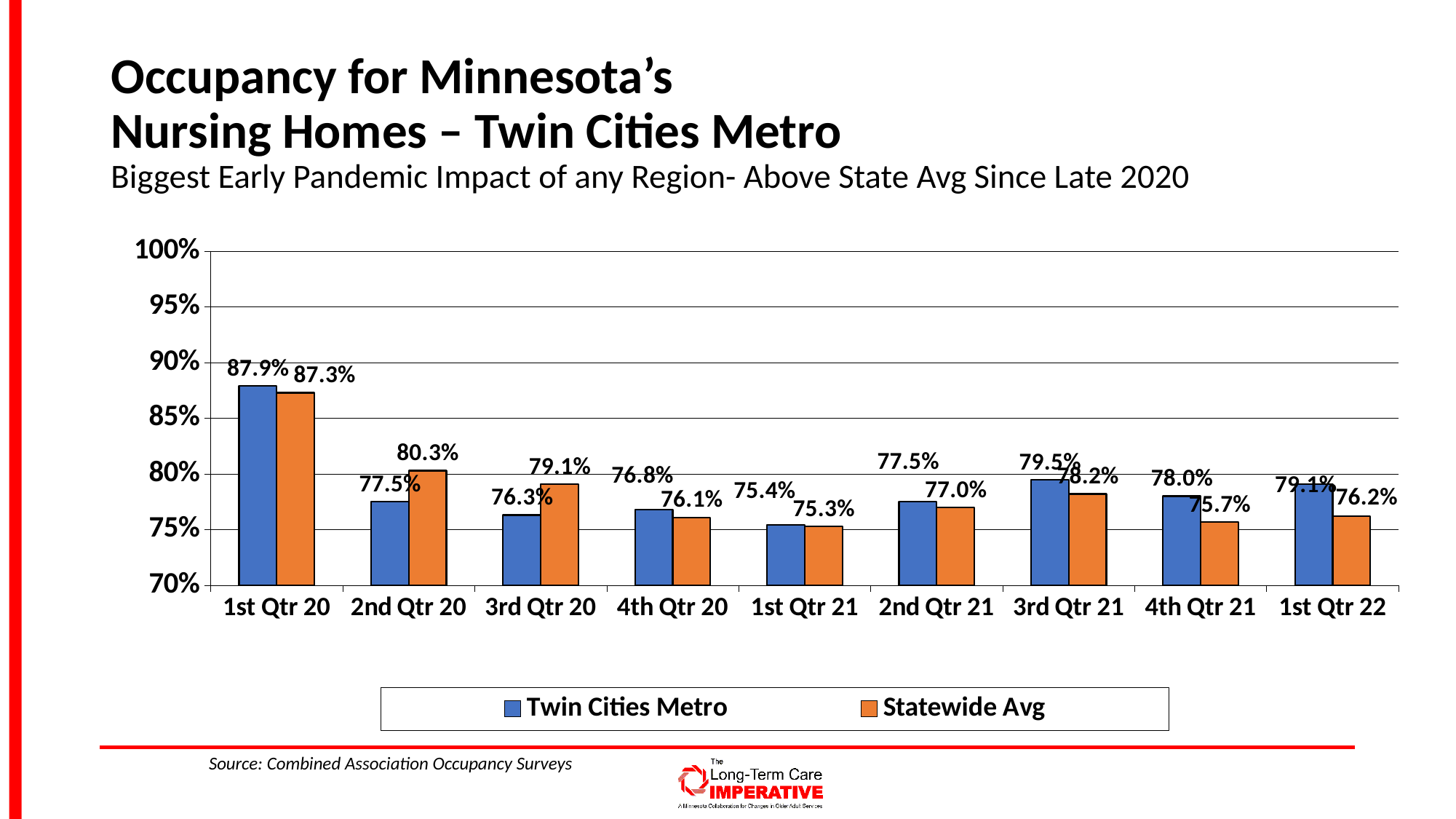
In which quarter is the Statewide Avg occupancy highest? 1st Qtr 20 What kind of chart is shown on the slide? Bar chart How many series does the legend list? 2 In 3rd Qtr 20, which series has the higher value, Twin Cities Metro or Statewide Avg? Statewide Avg What colour represents the Statewide Avg series in the legend? Orange What is the Twin Cities Metro occupancy value for 1st Qtr 20? 87.9% What is the Statewide Avg occupancy value for 2nd Qtr 20? 80.3% What is the Twin Cities Metro value for 4th Qtr 21? 78.0% How many quarters are shown on the x axis? 9 Does the Twin Cities Metro occupancy rise or fall from 1st Qtr 20 to 1st Qtr 21? Fall In which quarter is the Twin Cities Metro occupancy lowest? 1st Qtr 21 By how many percentage points does Twin Cities Metro exceed Statewide Avg in 1st Qtr 22? 2.9 percentage points